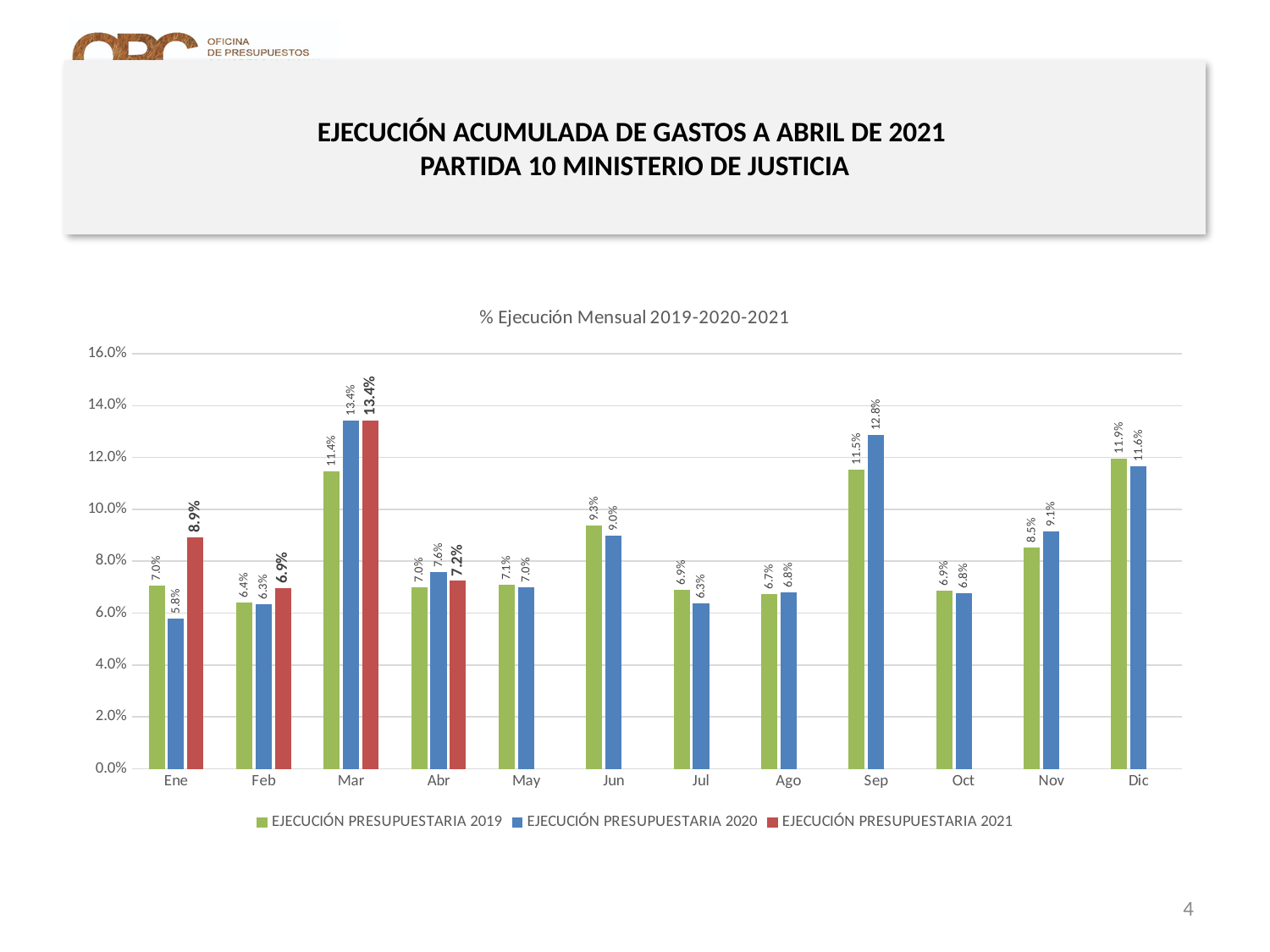
What is the value for EJECUCIÓN PRESUPUESTARIA 2021 in Ene? 8.9% What is the difference between the EJECUCIÓN PRESUPUESTARIA 2021 and EJECUCIÓN PRESUPUESTARIA 2019 values in Ene? 1.9% In which month is the EJECUCIÓN PRESUPUESTARIA 2020 value highest? Mar Which is larger in Abr: EJECUCIÓN PRESUPUESTARIA 2020 or EJECUCIÓN PRESUPUESTARIA 2021? EJECUCIÓN PRESUPUESTARIA 2020 How many months are shown on the x axis? 12 In which month is the EJECUCIÓN PRESUPUESTARIA 2020 value lowest? Ene How many series does the legend list? 3 Is the value for EJECUCIÓN PRESUPUESTARIA 2019 in Sep greater or less than 10.0%? greater What is the title of the chart? % Ejecución Mensual 2019-2020-2021 What is the value for EJECUCIÓN PRESUPUESTARIA 2020 in Sep? 12.8% What is the value for EJECUCIÓN PRESUPUESTARIA 2019 in Dic? 11.9% What kind of chart is shown on the slide? Bar chart